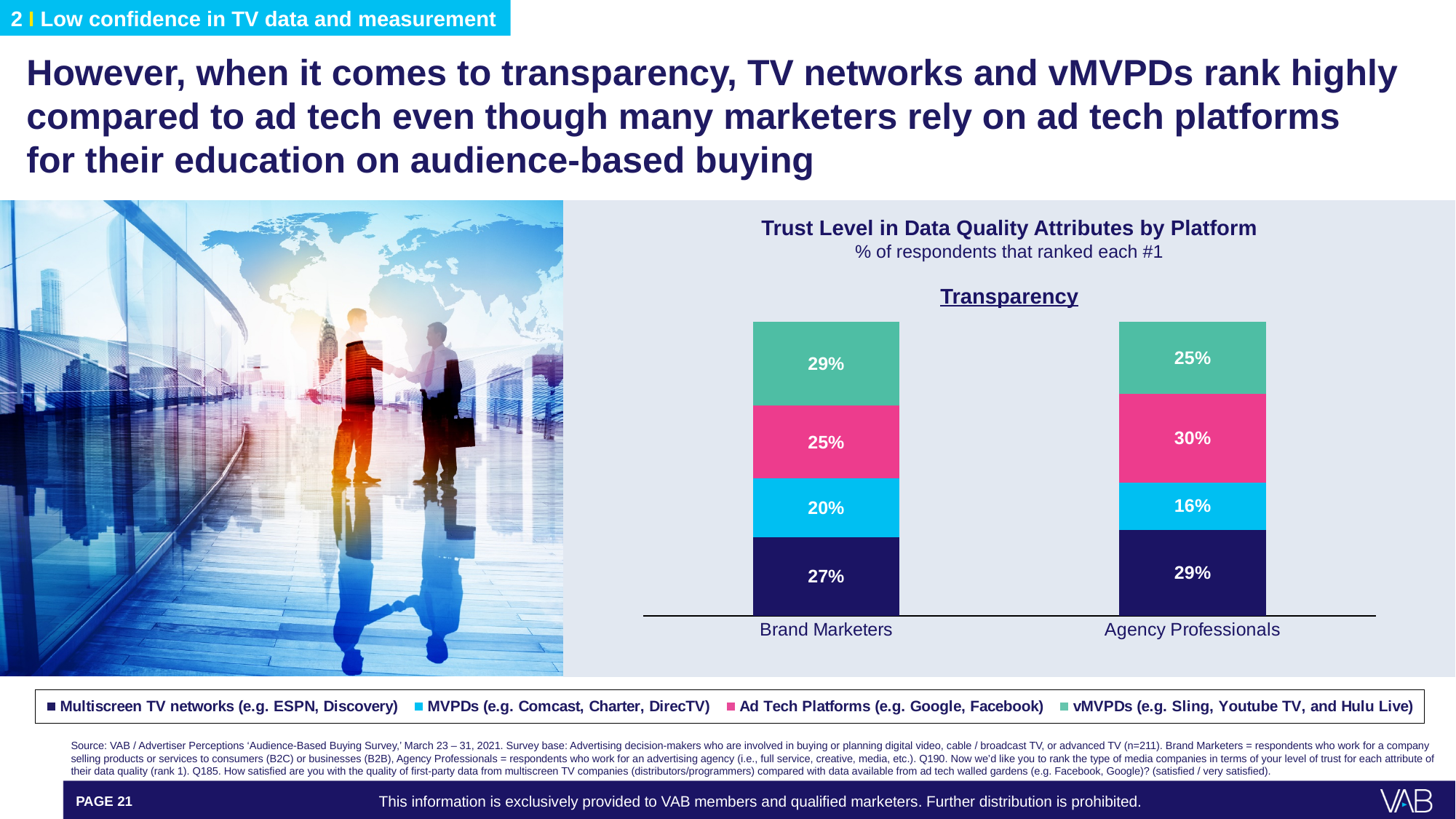
Which platform has the highest value among Brand Marketers? vMVPDs (e.g. Sling, Youtube TV, and Hulu Live) What is the difference between the MVPDs value for Brand Marketers and for Agency Professionals? 4% Which platform has the lowest value among Agency Professionals? MVPDs (e.g. Comcast, Charter, DirecTV) What is the value for Multiscreen TV networks among Agency Professionals? 29% What percentage of Agency Professionals ranked Ad Tech Platforms #1 for transparency? 30% What kind of chart is shown? Stacked bar chart How many series does the legend list? 4 What is the value for MVPDs among Brand Marketers? 20% Which is larger: the Ad Tech Platforms value for Brand Marketers or for Agency Professionals? Agency Professionals How many respondent groups (categories) are shown on the x axis? 2 What percentage of Brand Marketers ranked vMVPDs #1 for transparency? 29% What is the subtitle under the chart title 'Trust Level in Data Quality Attributes by Platform'? % of respondents that ranked each #1